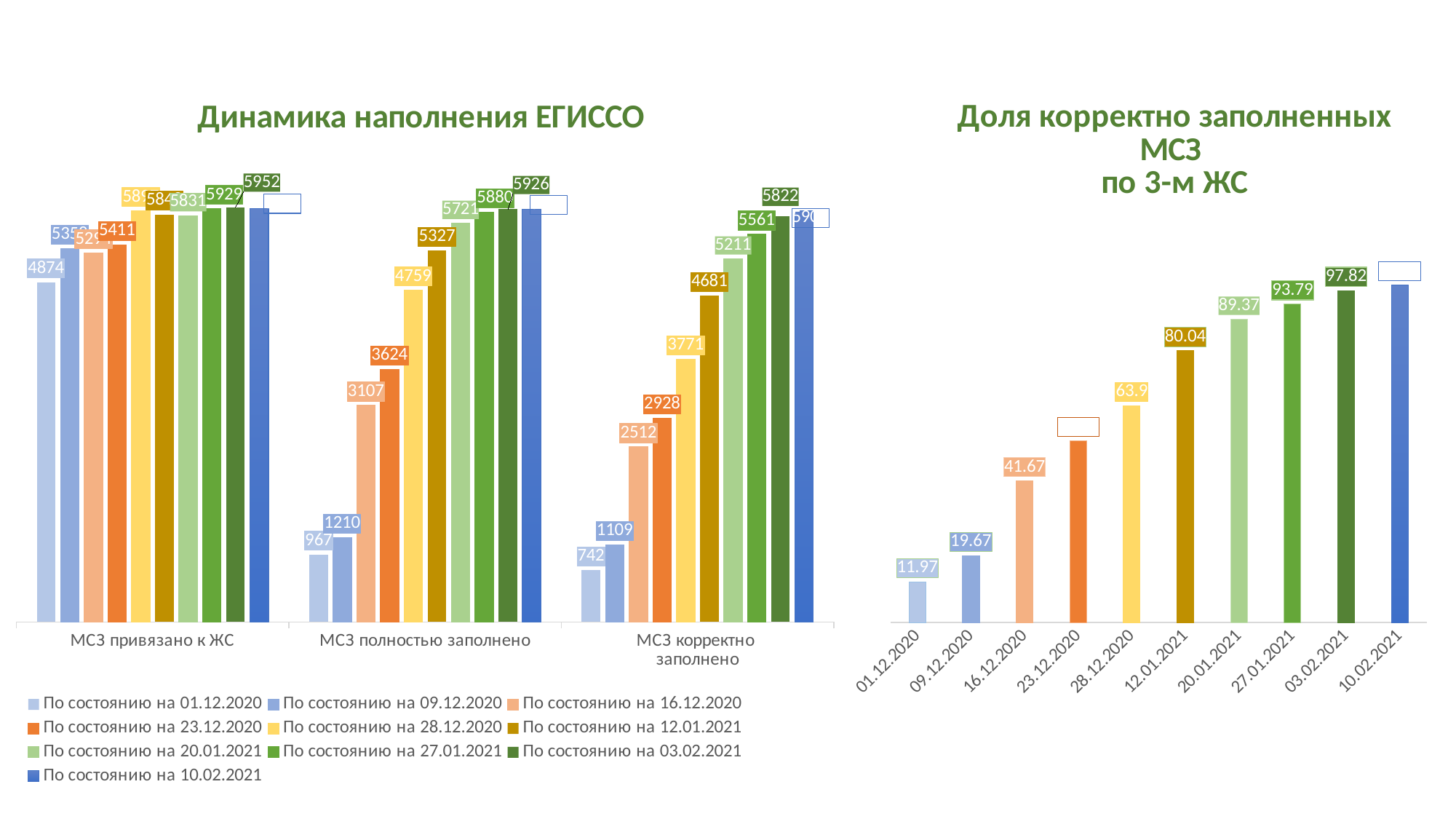
In the chart 'Доля корректно заполненных МСЗ по 3-м ЖС', what is the value for 16.12.2020? 41.67 How many series does the legend of the chart 'Динамика наполнения ЕГИССО' list? 10 In the chart 'Динамика наполнения ЕГИССО', what is the value for 'МСЗ привязано к ЖС' as of 03.02.2021? 5952 In the chart 'Доля корректно заполненных МСЗ по 3-м ЖС', do the values rise or fall from left to right along the x axis? rise In the chart 'Доля корректно заполненных МСЗ по 3-м ЖС', what is the difference between the values for 27.01.2021 and 20.01.2021? 4.42 In the chart 'Доля корректно заполненных МСЗ по 3-м ЖС', what is the value for 03.02.2021? 97.82 In the chart 'Динамика наполнения ЕГИССО', what is the value for 'МСЗ полностью заполнено' as of 23.12.2020? 3624 In the chart 'Динамика наполнения ЕГИССО', what is the difference between the values for 'МСЗ полностью заполнено' as of 09.12.2020 and as of 01.12.2020? 243 In the chart 'Доля корректно заполненных МСЗ по 3-м ЖС', which date has the lowest value? 01.12.2020 In the chart 'Динамика наполнения ЕГИССО', as of 12.01.2021, which is larger: 'МСЗ полностью заполнено' or 'МСЗ корректно заполнено'? МСЗ полностью заполнено How many dates are shown on the x axis of the chart 'Доля корректно заполненных МСЗ по 3-м ЖС'? 10 In the chart 'Динамика наполнения ЕГИССО', what is the value for 'МСЗ корректно заполнено' as of 01.12.2020? 742